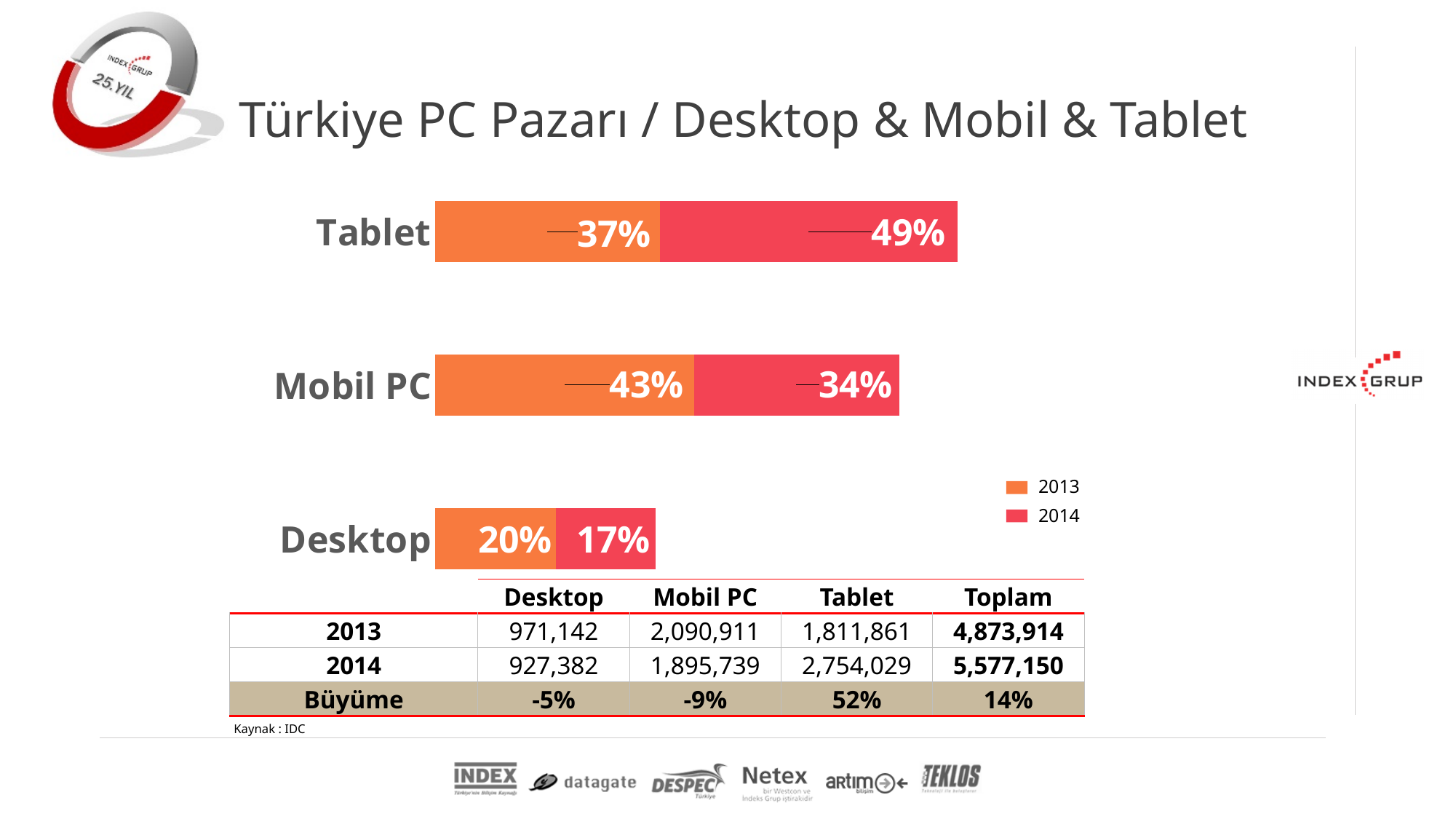
What is the 2013 value for Mobil PC in the chart? 43% For Mobil PC, which is larger in the chart: the 2013 value or the 2014 value? 2013 What is the difference between the 2014 and 2013 values for Tablet in the chart? 12% What is the total of the stacked bar for Mobil PC in the chart? 77% How many series does the chart legend list? 2 How many categories are shown in the chart? 3 Which category has the highest 2014 value in the chart? Tablet Which category has the lowest 2013 value in the chart? Desktop What kind of chart is shown on the slide? Stacked bar chart What is the 2014 value for Tablet in the chart? 49% What is the 2013 value for Desktop in the chart? 20% What is the 2014 value for Desktop in the chart? 17%